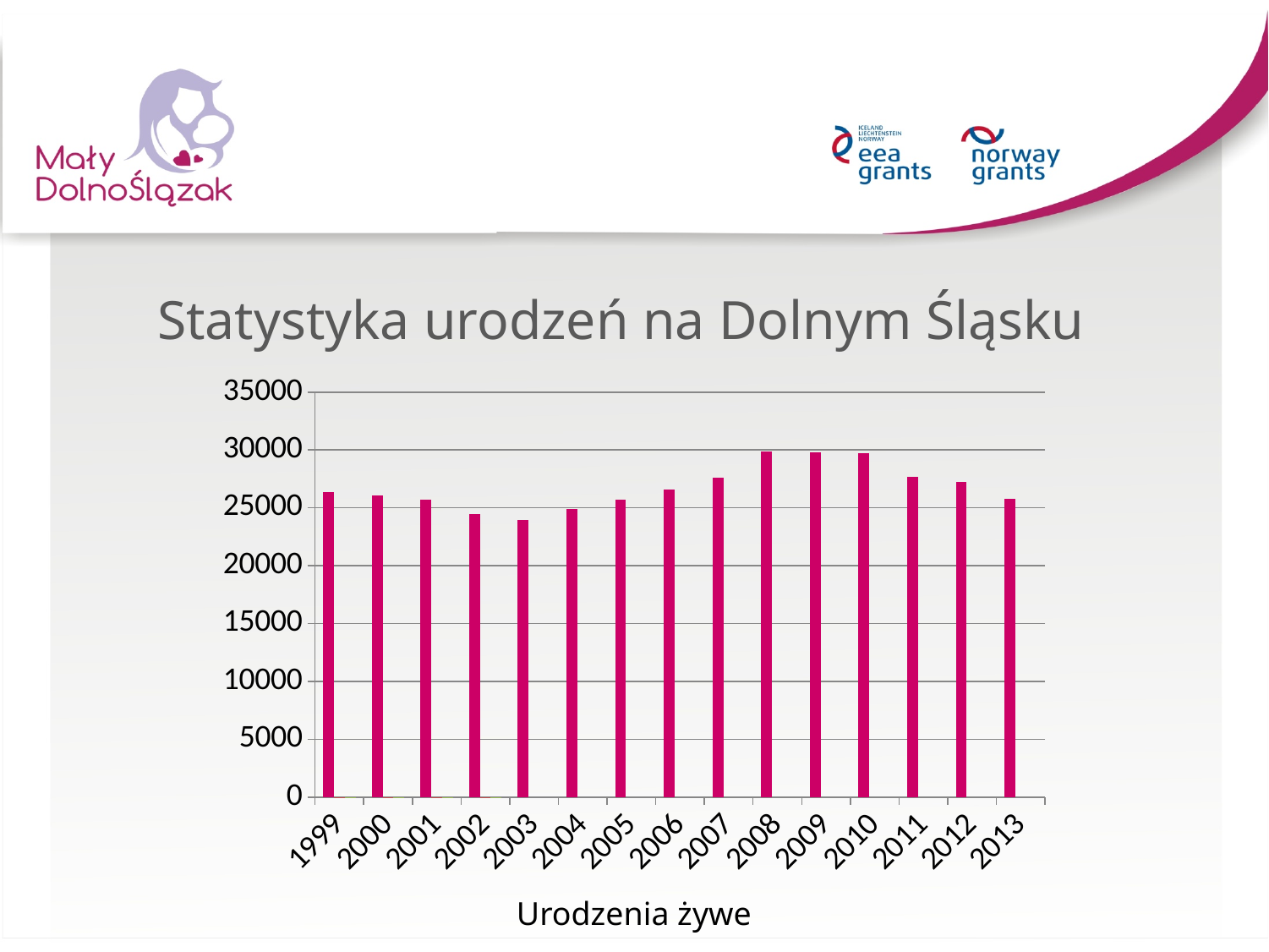
How many years are shown on the x axis of the chart? 15 Is the value for 2003 greater or less than 25000? less What is the title of the chart? Statystyka urodzeń na Dolnym Śląsku Do the values rise or fall from 2003 to 2008? rise Which year has the larger value, 2003 or 2008? 2008 Is the value for 2002 greater or less than 25000? less Is the value for 2008 greater or less than 25000? greater What kind of chart is shown on the slide? bar chart Which year has the larger value, 2002 or 2007? 2007